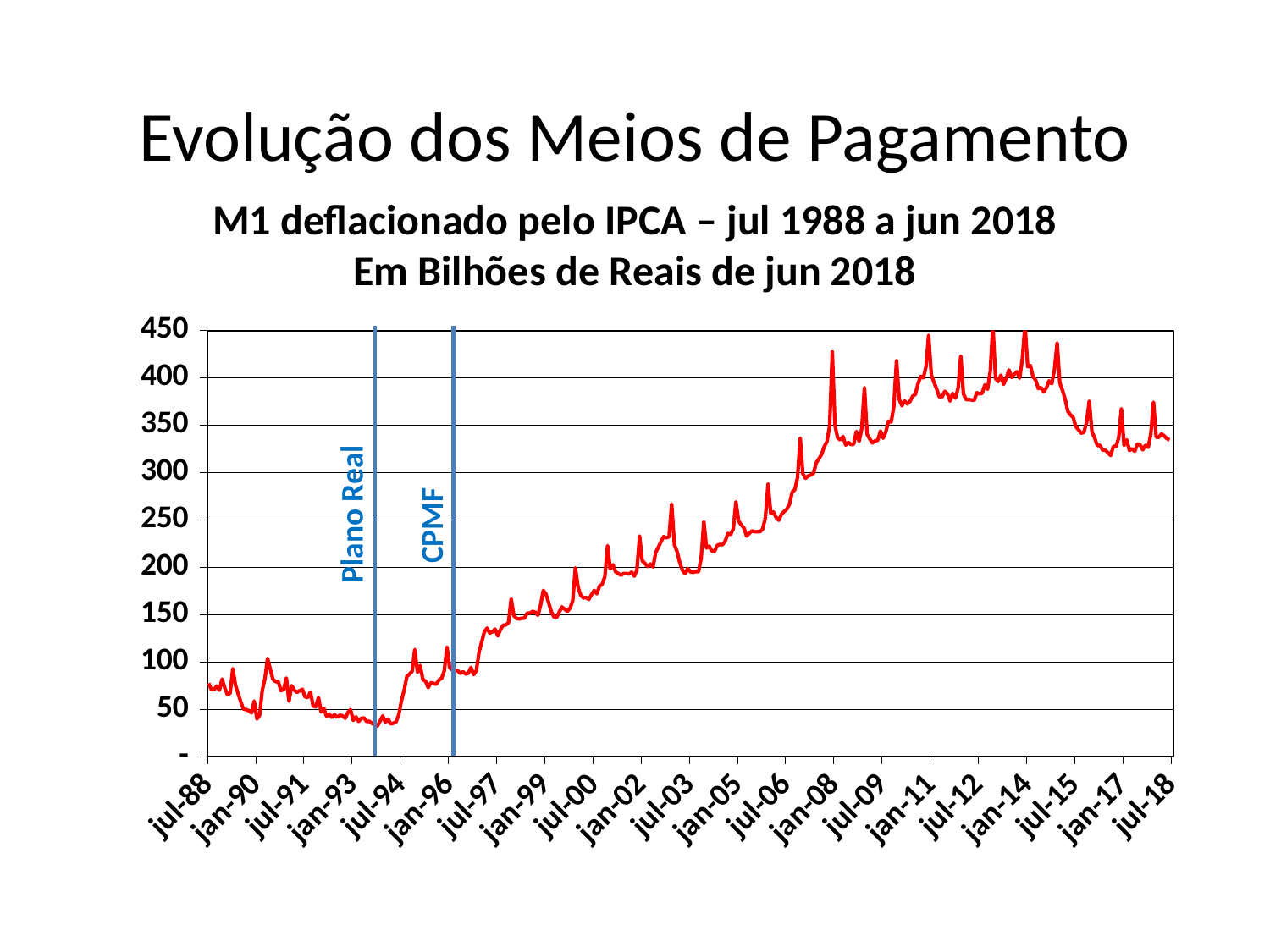
Is the value at jan-09 greater or less than 300? greater What are the labels on the two vertical reference lines in the chart? Plano Real and CPMF What is the chart's title? M1 deflacionado pelo IPCA – jul 1988 a jun 2018 Em Bilhões de Reais de jun 2018 Which is larger, the value at jul-97 or the value at jan-08? jan-08 Is the value at jan-00 greater or less than 150? greater Is the value at jan-17 greater or less than 350? less What kind of chart is shown on the slide? line chart Does the line rise or fall between jan-14 and jul-18? fall Overall, does the line rise or fall from jul-88 to jul-18? rise